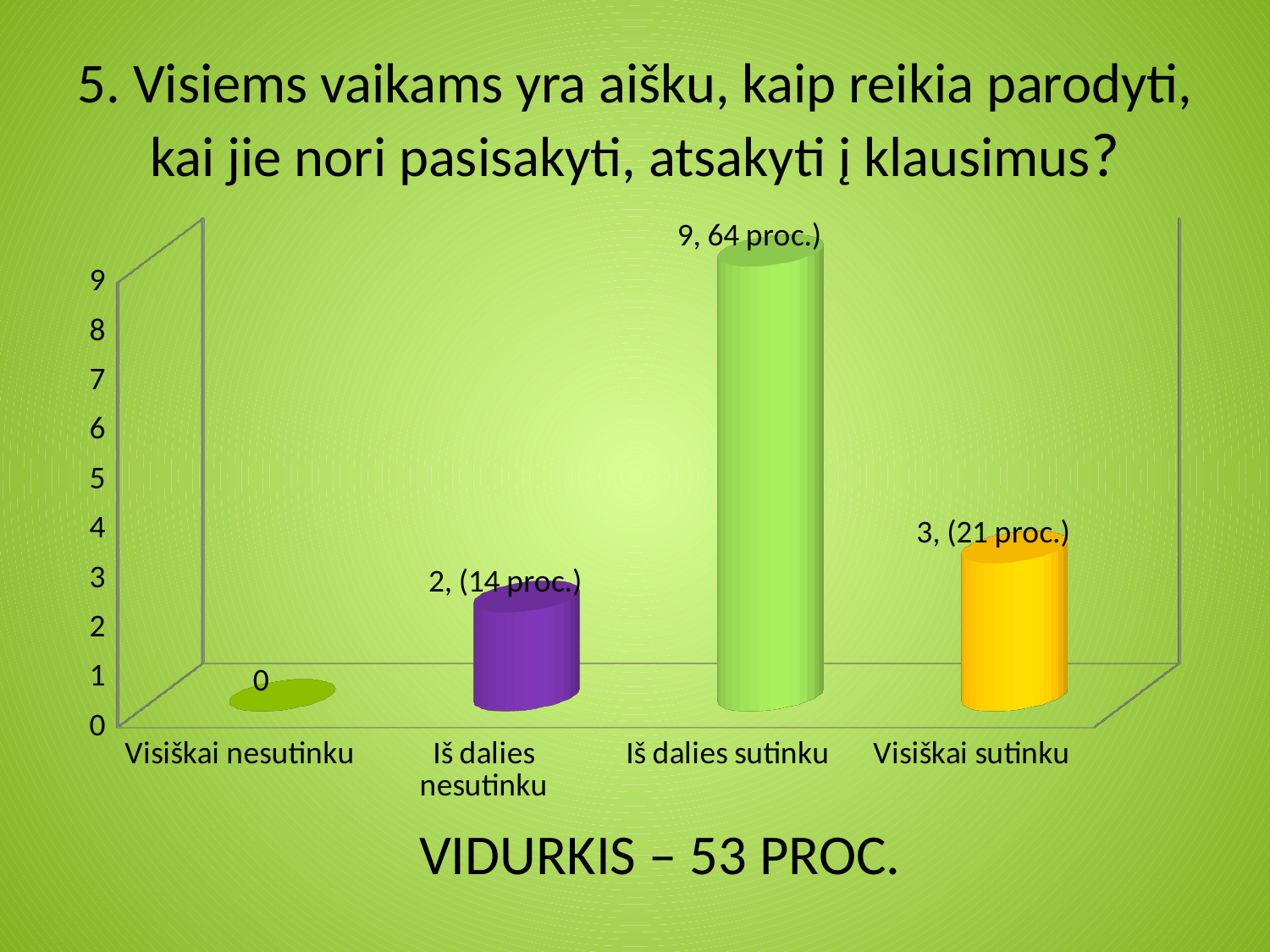
How many categories are shown on the x axis? 4 What is the difference in count between "Iš dalies sutinku" and "Visiškai sutinku"? 6 What is the value for "Visiškai sutinku"? 3, (21 proc.) What is the value for "Visiškai nesutinku"? 0 Which category has the highest value? Iš dalies sutinku What average (VIDURKIS) is stated below the chart? 53 PROC. Which category has the lowest value? Visiškai nesutinku What kind of chart is shown on the slide? bar chart What colour is the bar for "Visiškai sutinku"? yellow What is the value for "Iš dalies nesutinku"? 2, (14 proc.) Which is larger, the value for "Visiškai sutinku" or the value for "Iš dalies nesutinku"? Visiškai sutinku What is the value for "Iš dalies sutinku"? 9, 64 proc.)